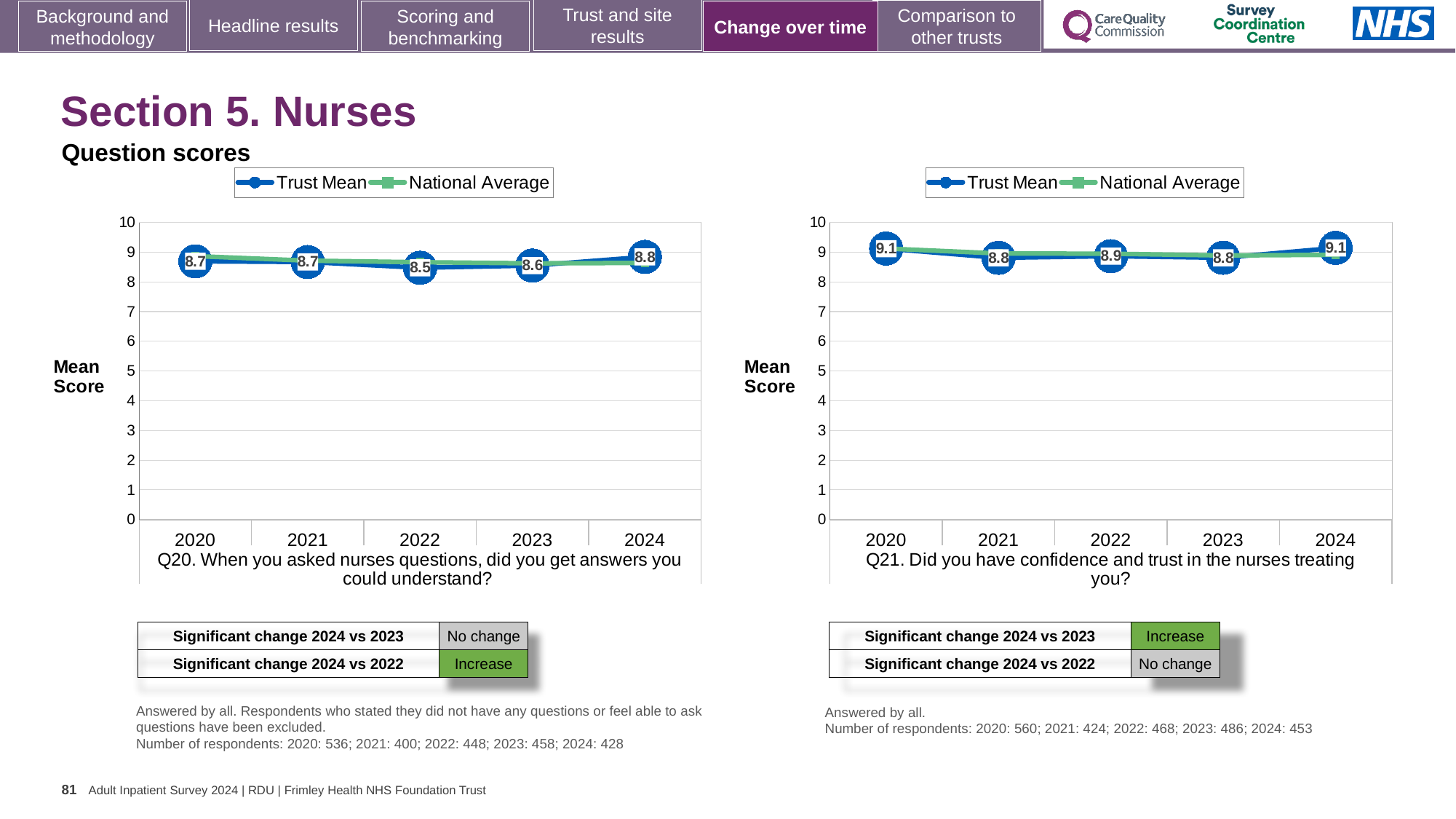
How many series does the legend of the Q20 chart on the left list? 2 What type of chart is the Q21 chart on the right? Line chart In the Q20 chart on the left, which year has the lowest Trust Mean score? 2022 In the Q21 chart on the right, what is the difference between the Trust Mean scores for 2024 and 2023? 0.3 In the Q21 chart on the right, is the Trust Mean score higher in 2020 or in 2021? 2020 In the Q21 chart on the right, what is the Trust Mean score for 2021? 8.8 In the Q20 chart on the left, is the National Average value for 2024 greater or less than 8? greater How many years are plotted on the x axis of the Q21 chart on the right? 5 What are the two series named in the legend of the Q21 chart on the right? Trust Mean and National Average In the Q20 chart on the left, which year has the highest Trust Mean score? 2024 In the Q20 chart on the left, what is the Trust Mean score for 2022? 8.5 In the Q20 chart on the left, what is the difference between the Trust Mean scores for 2024 and 2022? 0.3